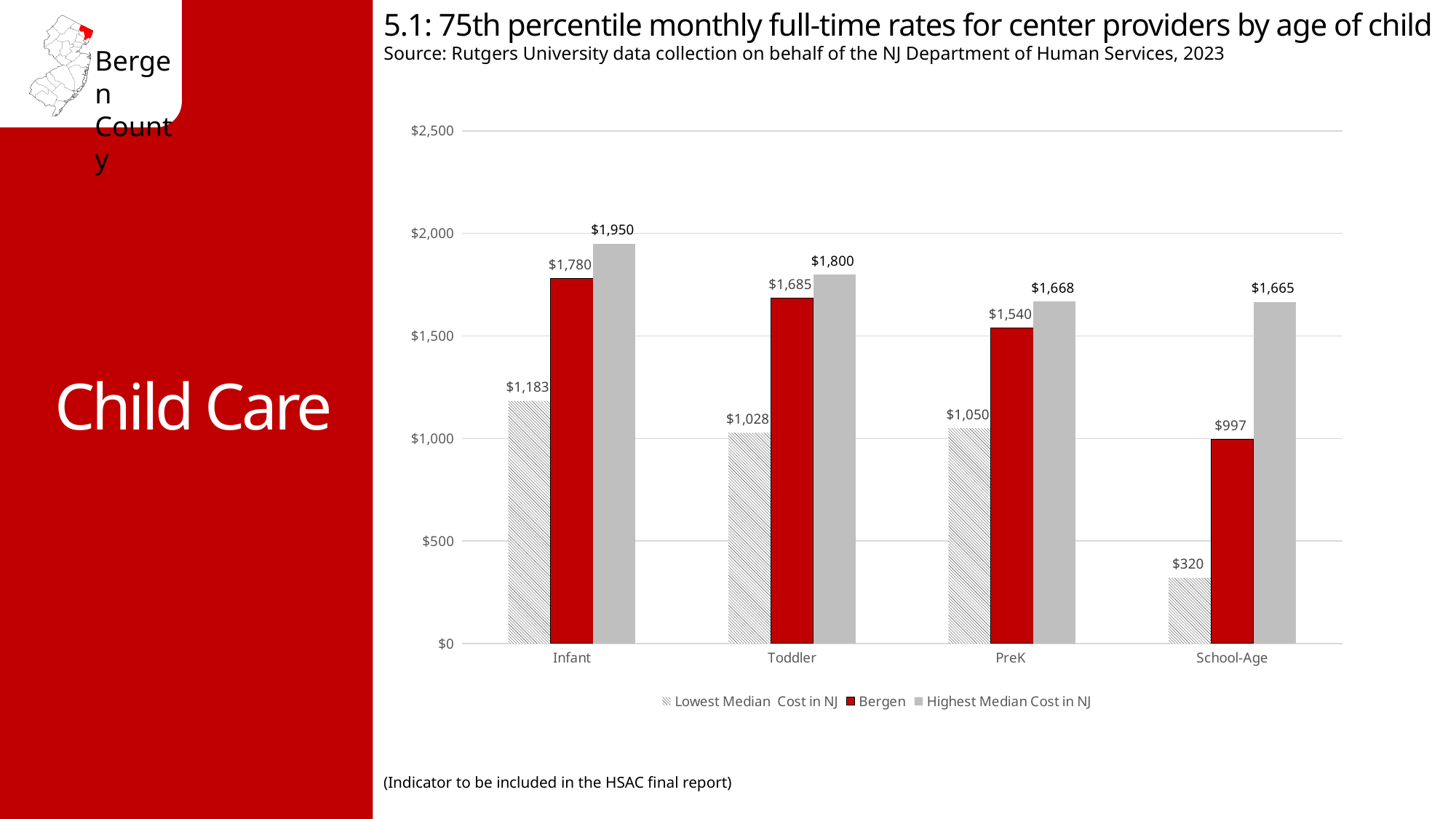
How many series does the legend list? 3 Which age category has the highest Bergen value? Infant What is the Lowest Median Cost in NJ for Toddler? $1,028 What is the Highest Median Cost in NJ for School-Age? $1,665 Do the Bergen values rise or fall from Infant to School-Age? fall What is the Bergen value for Infant? $1,780 Is the Bergen value for Toddler greater or less than $1,500? greater Which is larger for School-Age: the Bergen value or the Lowest Median Cost in NJ? Bergen Which age category has the lowest Lowest Median Cost in NJ value? School-Age What is the difference between the Highest Median Cost in NJ and the Bergen value for PreK? $128 How many age categories are shown on the x axis? 4 What kind of chart is shown on the slide? bar chart